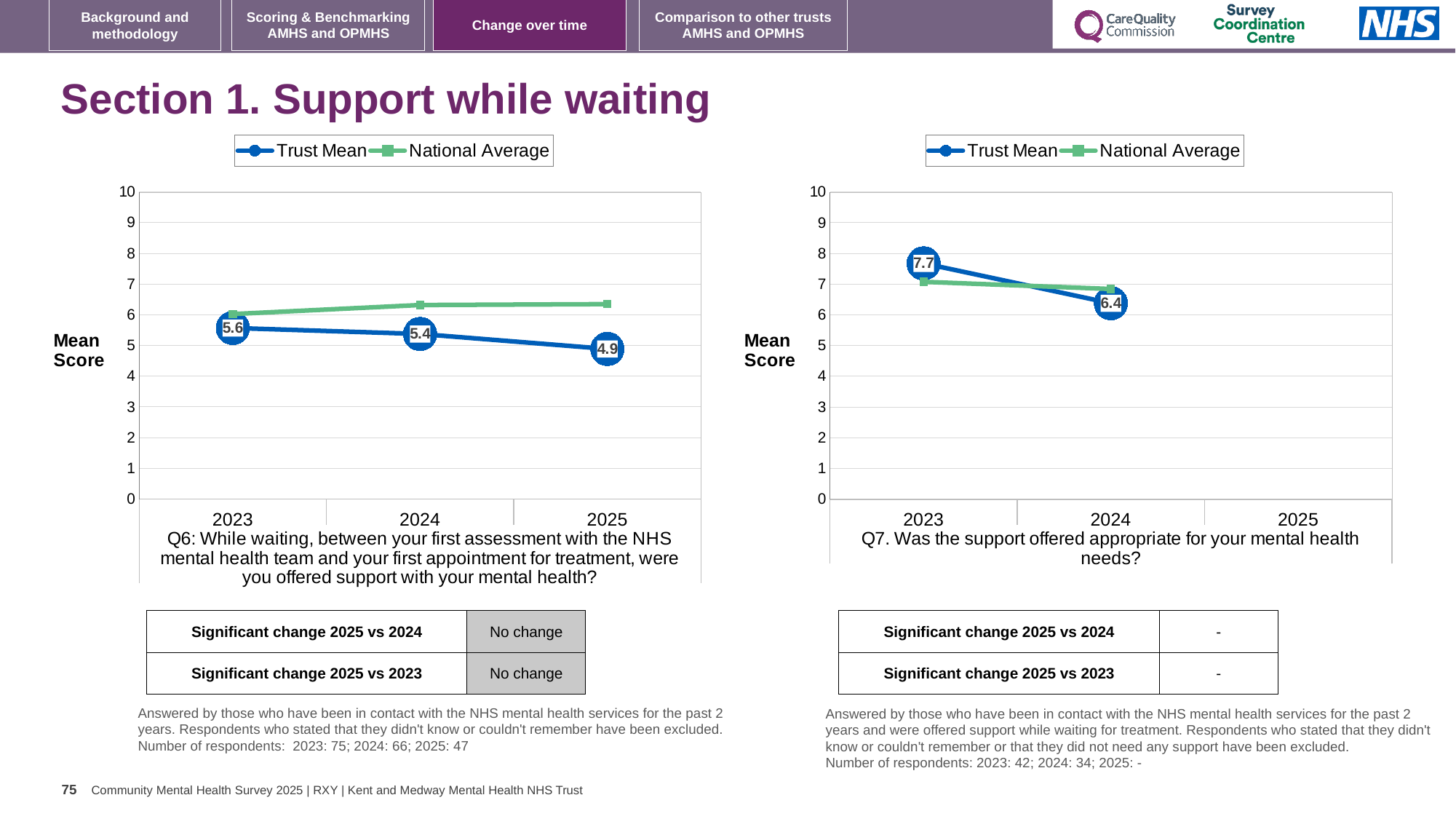
On the left chart (Q6), what is the Trust Mean score for 2025? 4.9 On the left chart (Q6), in 2025 which is higher, the Trust Mean or the National Average? National Average On the right chart (Q7), what is the Trust Mean score for 2024? 6.4 On the left chart (Q6), what is the difference between the Trust Mean scores for 2023 and 2025? 0.7 On the right chart (Q7), is the National Average for 2023 greater or less than 8? less What kind of chart is the right chart (Q7)? line chart On the right chart (Q7), what is the Trust Mean score for 2023? 7.7 How many series does the legend of the left chart (Q6) list? 2 On the left chart (Q6), does the Trust Mean rise or fall from 2023 to 2025? fall On the left chart (Q6), what is the Trust Mean score for 2023? 5.6 On the left chart (Q6), which year has the lowest Trust Mean score? 2025 On the right chart (Q7), what is the difference between the Trust Mean scores for 2023 and 2024? 1.3